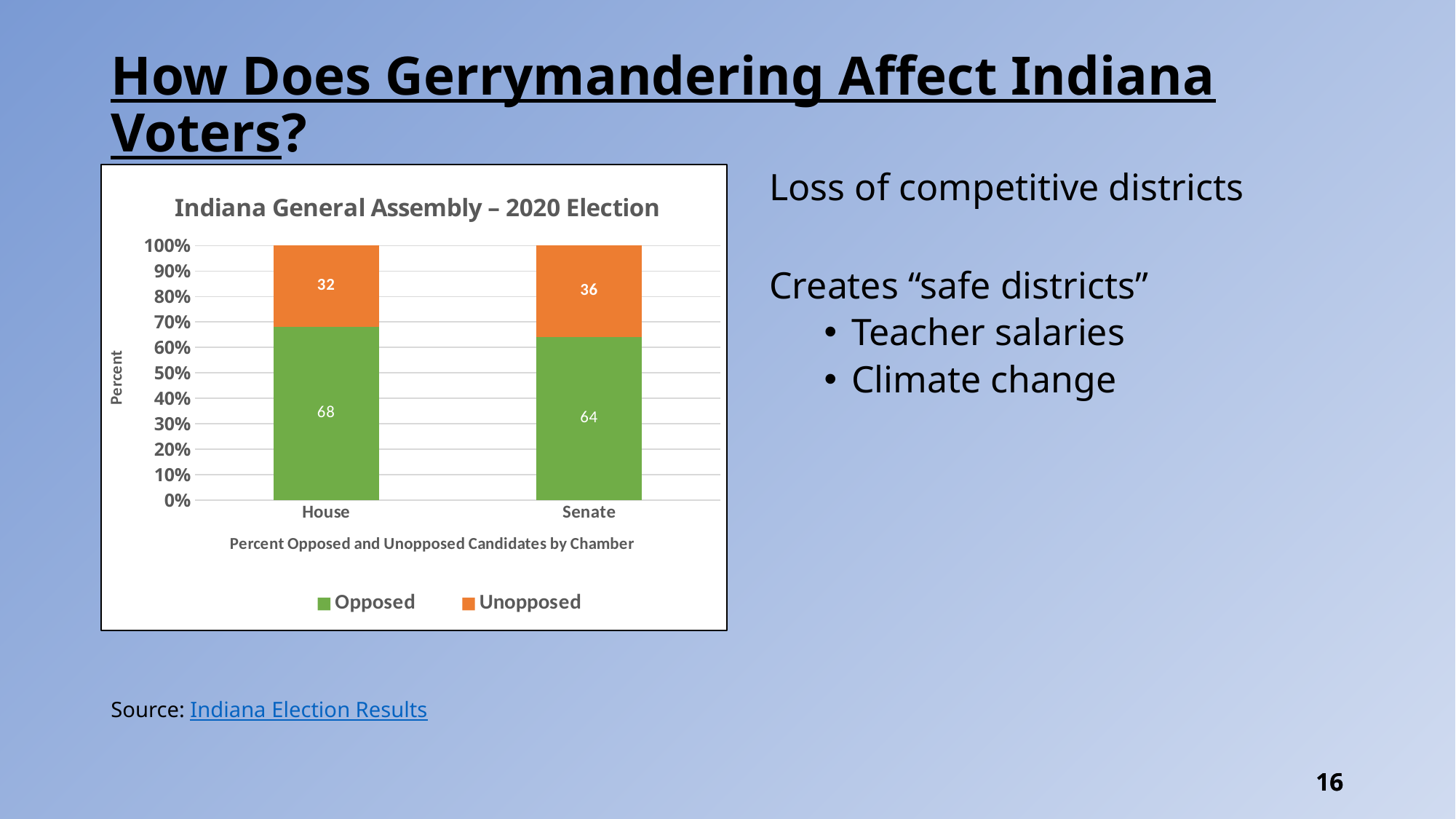
Is the Opposed value for House larger than the Opposed value for Senate? Yes Which chamber has the higher Unopposed value? Senate What kind of chart is shown? Stacked bar chart What is the title of the chart? Indiana General Assembly – 2020 Election Which chamber has the lower Opposed value? Senate What is the difference between the Opposed values for House and Senate? 4 How many chambers are shown on the x axis? 2 How many series does the legend list? 2 What is the Unopposed value for House? 32 What is the Unopposed value for Senate? 36 What is the Opposed value for Senate? 64 What is the Opposed value for House? 68